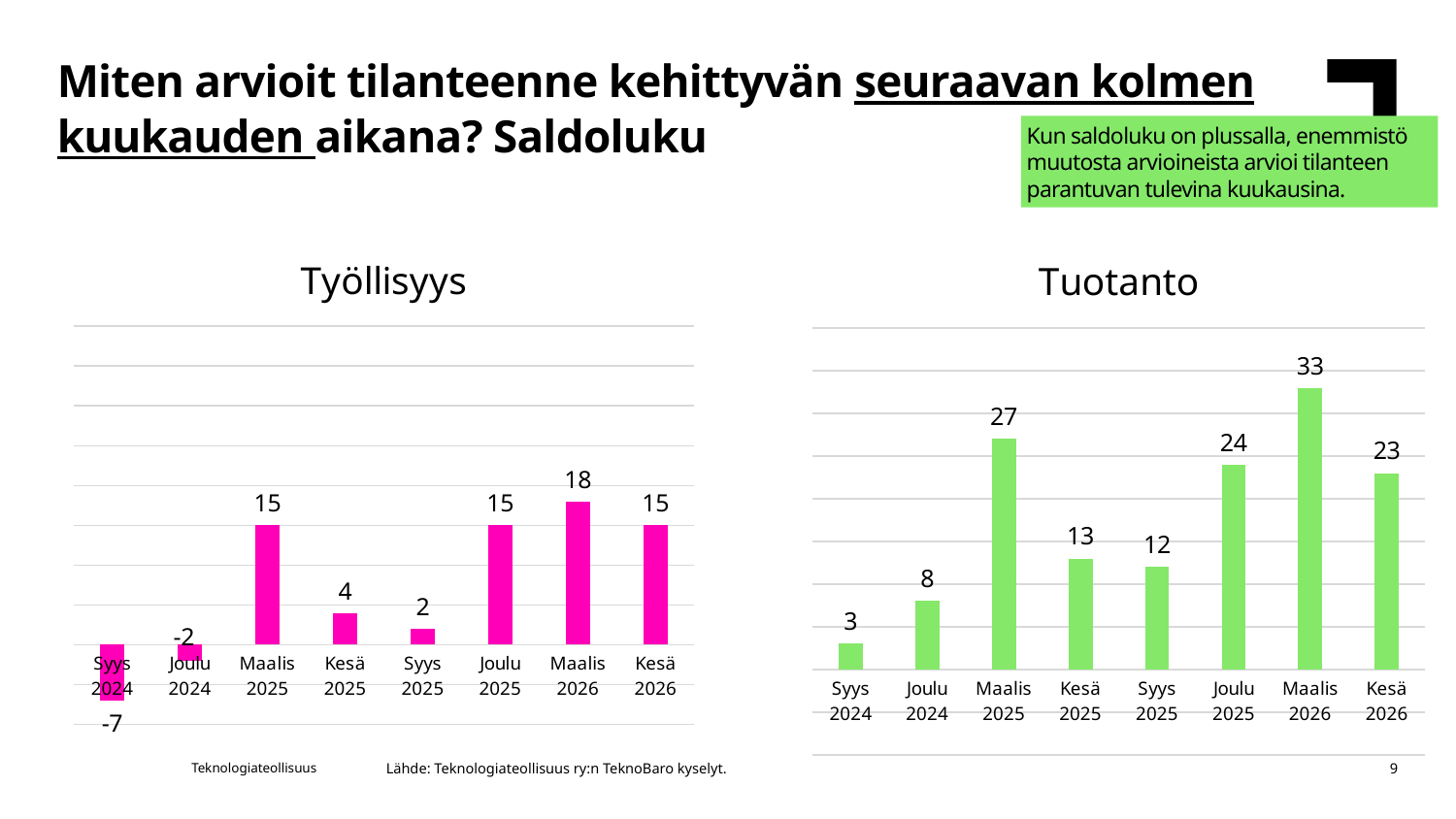
In the Tuotanto chart, which period has the highest value? Maalis 2026 In the Työllisyys chart, what is the value for Maalis 2026? 18 In the Työllisyys chart, which period has the lowest value? Syys 2024 In the Työllisyys chart, what is the difference between the values for Maalis 2025 and Kesä 2025? 11 In the Tuotanto chart, what is the value for Joulu 2025? 24 In the Tuotanto chart, what is the difference between the values for Maalis 2026 and Kesä 2026? 10 How many periods are shown on the x axis of the Työllisyys chart? 8 In the Tuotanto chart, which period has the lowest value? Syys 2024 In the Työllisyys chart, what is the value for Syys 2024? -7 What colour are the bars in the Työllisyys chart? Pink What kind of chart is the Tuotanto chart? Bar chart In the Tuotanto chart, which is larger, the value for Maalis 2025 or the value for Joulu 2025? Maalis 2025